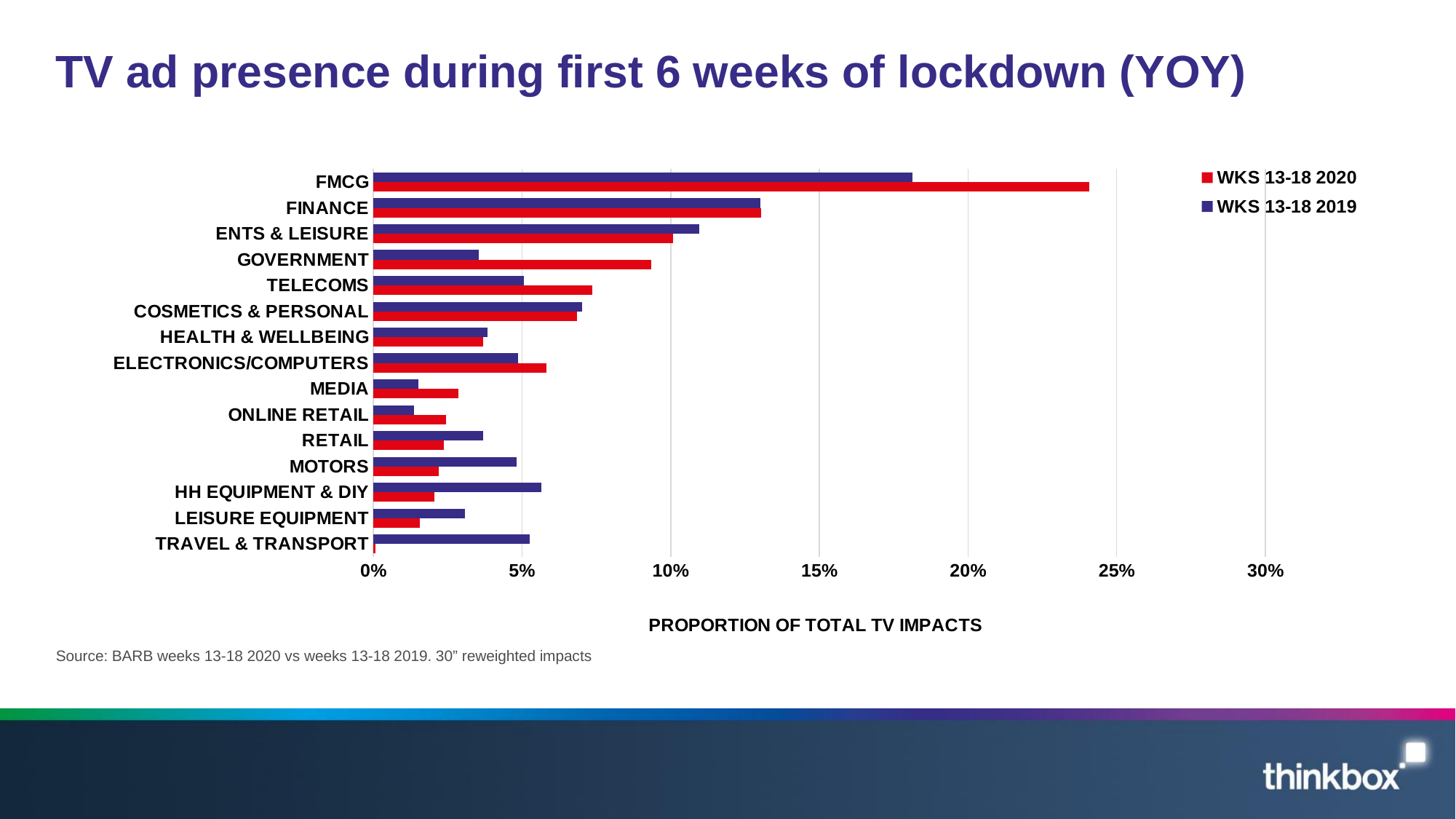
Which category has the highest value for WKS 13-18 2019? FMCG How many series does the legend list? 2 What kind of chart is shown on the slide? bar chart How many categories are shown on the chart? 15 For GOVERNMENT, which series has the larger value, WKS 13-18 2020 or WKS 13-18 2019? WKS 13-18 2020 Which category has the highest value for WKS 13-18 2020? FMCG Which category has the lowest value for WKS 13-18 2020? TRAVEL & TRANSPORT Is the WKS 13-18 2020 value for FINANCE greater or less than 10%? greater Is the WKS 13-18 2020 value for FMCG greater or less than 20%? greater For MOTORS, which series has the larger value, WKS 13-18 2020 or WKS 13-18 2019? WKS 13-18 2019 What is the label of the x axis? PROPORTION OF TOTAL TV IMPACTS Is the WKS 13-18 2019 value for GOVERNMENT greater or less than 5%? less